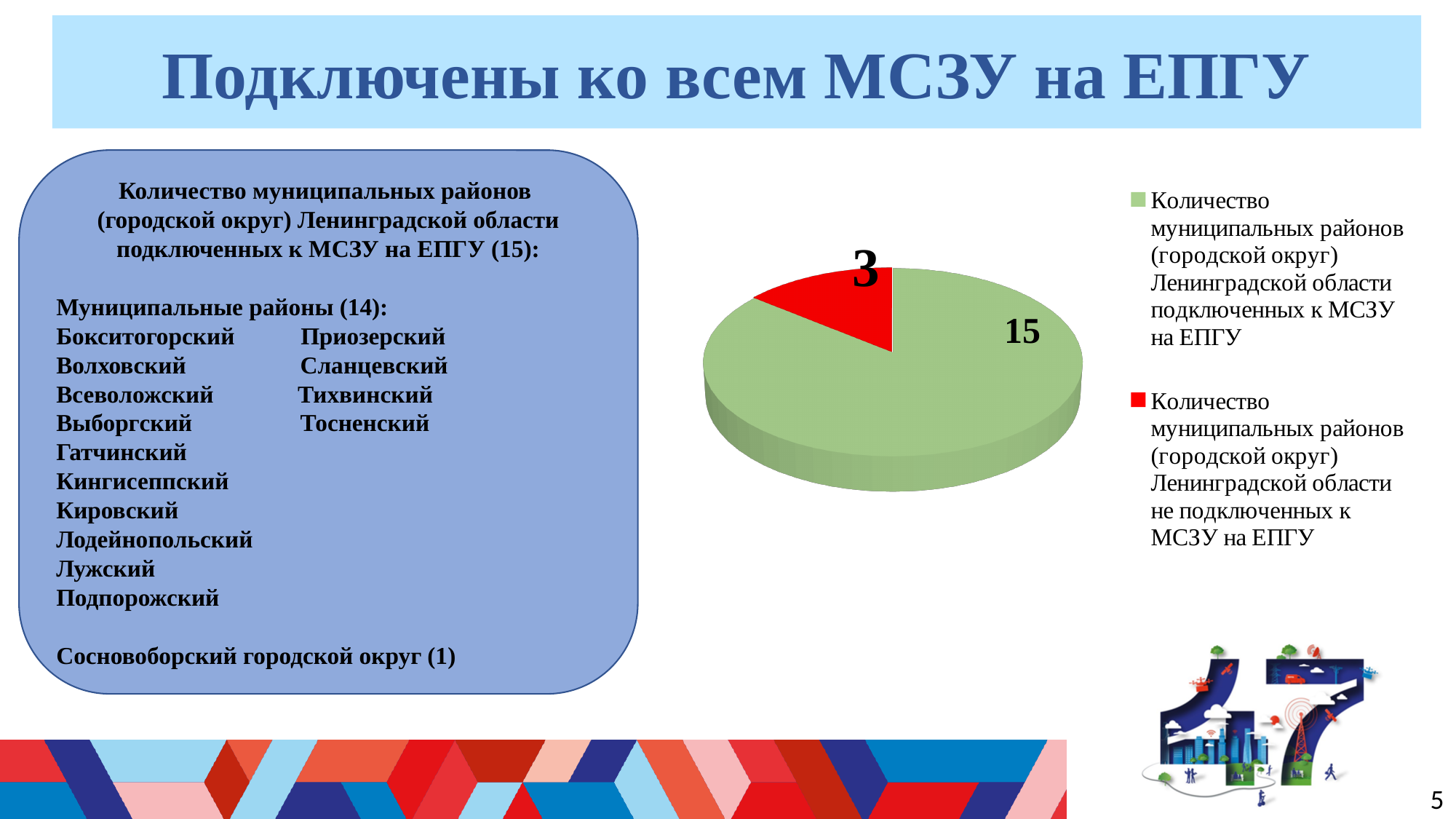
Which is larger in the pie chart: the number of connected districts or the number of not connected districts? connected districts (15) What kind of chart is shown on the slide? pie chart What is the total of the two values shown in the pie chart? 18 Which slice of the pie chart is the smallest? Количество муниципальных районов (городской округ) Ленинградской области не подключенных к МСЗУ на ЕПГУ (3) How many slices does the pie chart have? 2 How many entries does the legend of the pie chart list? 2 What colour is the slice representing districts connected to МСЗУ on ЕПГУ? green What is the value of the red slice (municipal districts not connected to МСЗУ on ЕПГУ)? 3 What is the difference between the number of connected and not connected municipal districts in the pie chart? 12 What is the value of the green slice (municipal districts connected to МСЗУ on ЕПГУ)? 15 Which slice of the pie chart is the largest? Количество муниципальных районов (городской округ) Ленинградской области подключенных к МСЗУ на ЕПГУ (15) What colour is the slice representing districts not connected to МСЗУ on ЕПГУ? red